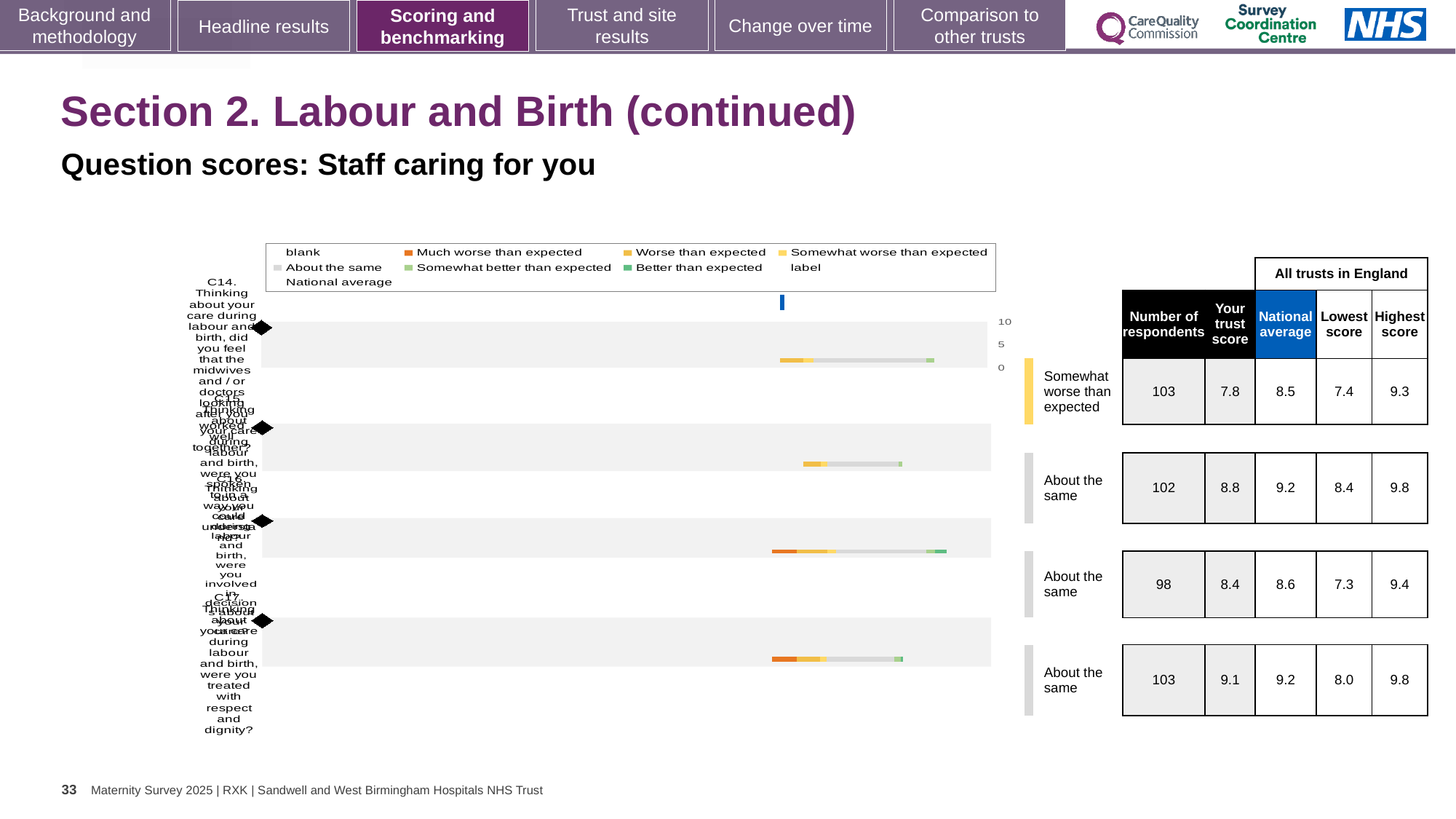
In the chart legend, what colour represents 'Better than expected'? green What is the national average for question C15 (spoken to in a way you could understand)? 9.2 In the chart legend, what colour represents 'Much worse than expected'? orange How many questions (bars) are plotted in the chart? 4 For question C15, which is larger: the trust score or the national average? national average What is the highest score among all trusts in England for question C17? 9.8 Which question has the lowest trust score? C14 (midwives and/or doctors worked well together) What is the difference between the national average and the trust score for question C14? 0.7 Which question has the highest trust score? C17 (treated with respect and dignity) What kind of chart is shown on the slide? bar chart How many respondents answered question C16 (involved in decisions about your care)? 98 What is the trust score for question C14 (midwives and/or doctors worked well together)? 7.8